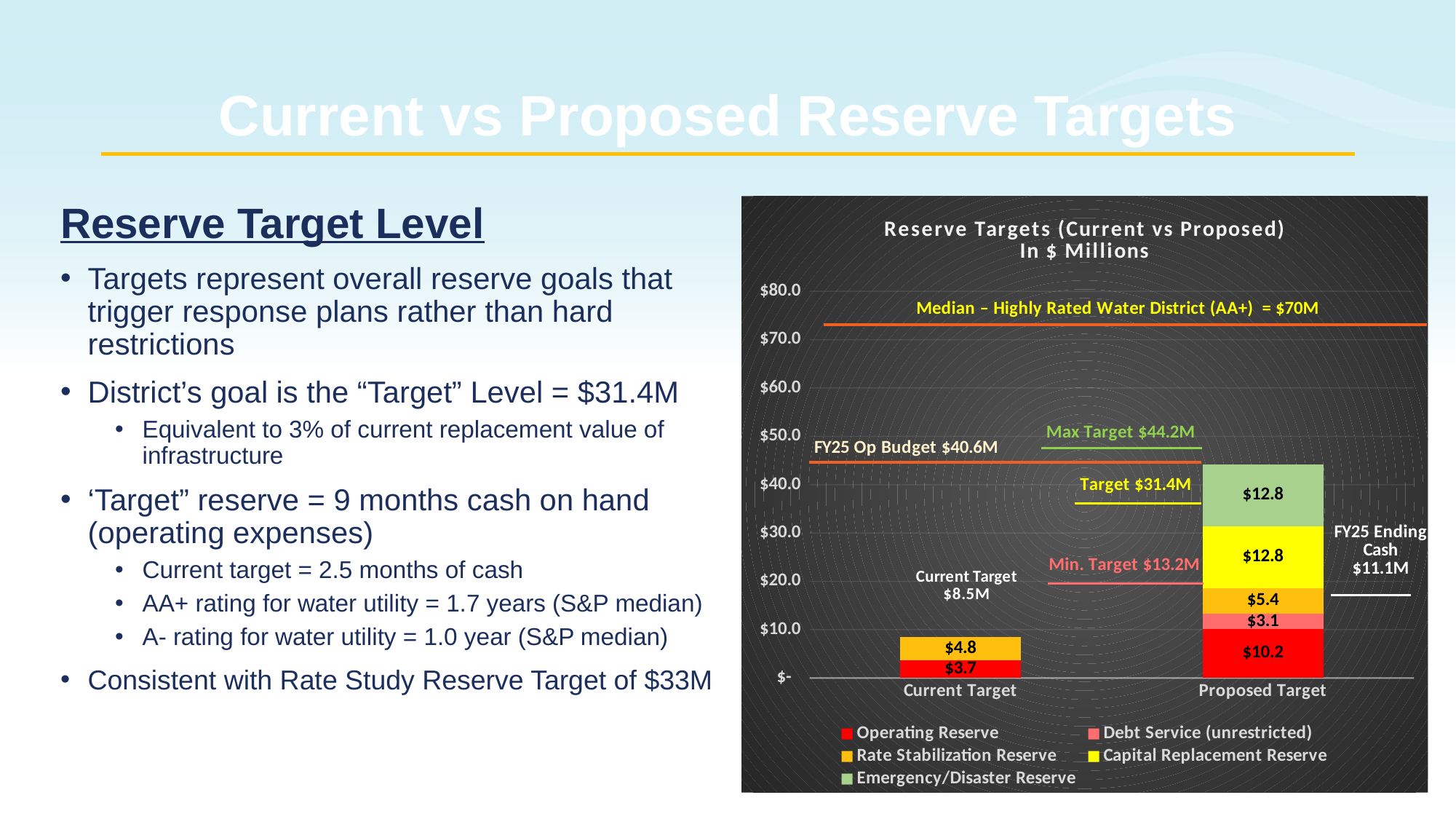
Which bar is taller, Current Target or Proposed Target? Proposed Target What is the Emergency/Disaster Reserve value in the Proposed Target bar? $12.8 Is the total of the Proposed Target bar greater or less than $40.0? greater How much larger is the Operating Reserve in the Proposed Target than in the Current Target? $6.5 How many series does the chart's legend list? 5 What kind of chart is shown on the slide? Stacked bar chart What value does the Max Target line on the chart indicate? $44.2M How many categories are shown on the x axis of the chart? 2 What is the total of the Current Target stacked bar? $8.5M What is the Debt Service (unrestricted) value in the Proposed Target bar? $3.1 What is the Operating Reserve value in the Proposed Target bar? $10.2 What is the Rate Stabilization Reserve value in the Current Target bar? $4.8